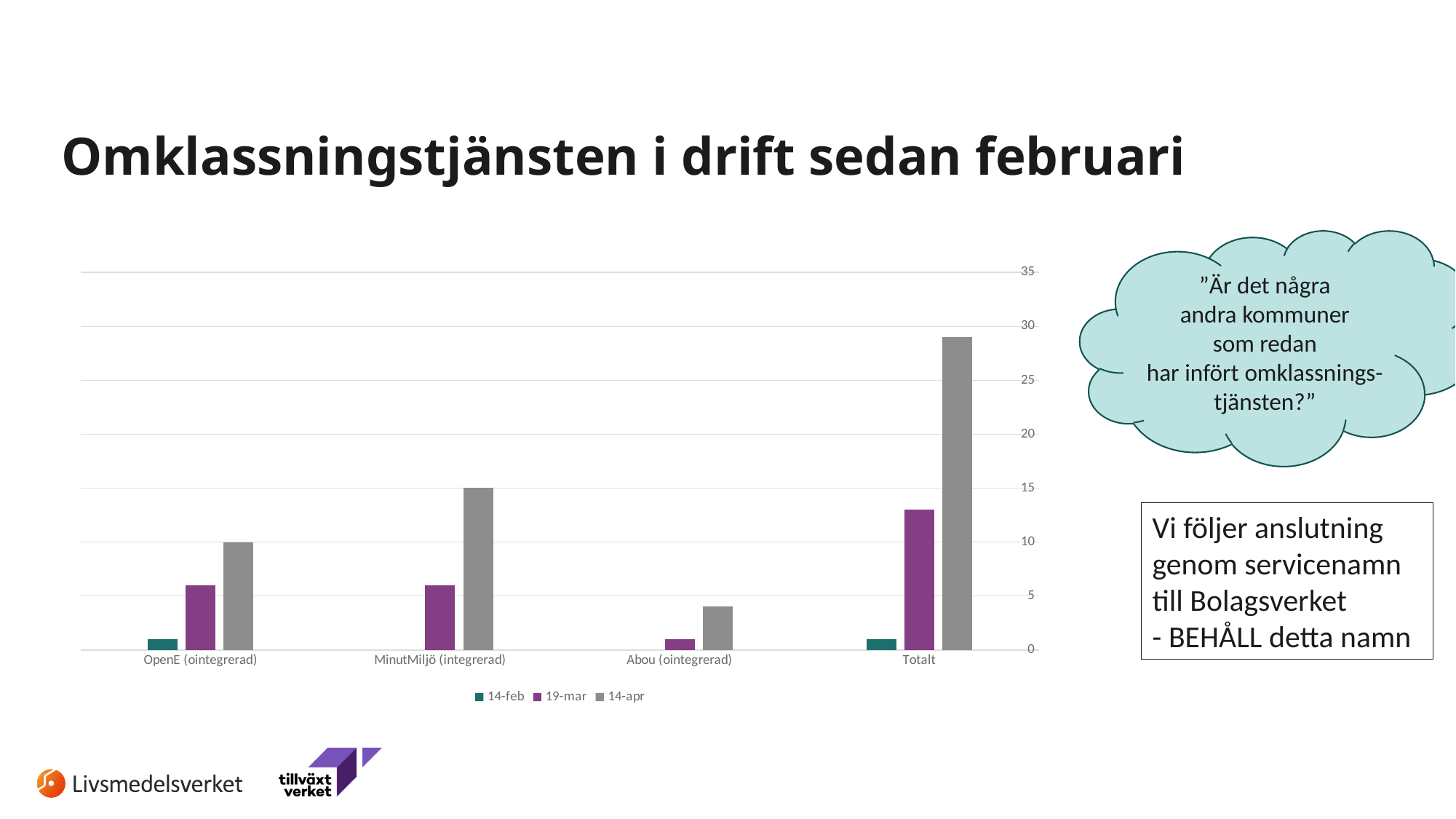
How many categories are shown on the x axis? 4 Which is larger, the 14-apr value for MinutMiljö (integrerad) or the 14-apr value for OpenE (ointegrerad)? MinutMiljö (integrerad) How many series does the legend list? 3 What is the 14-apr value for MinutMiljö (integrerad)? 15 Which series is shown in grey in the legend? 14-apr What is the 14-apr value for OpenE (ointegrerad)? 10 Which category has the highest 14-apr bar? Totalt What kind of chart is shown on the slide? bar chart Is the 14-apr value for Abou (ointegrerad) greater or less than 5? less Which category has the lowest 14-apr bar? Abou (ointegrerad) Is the 19-mar value for Totalt greater or less than 10? greater Is the 14-apr value for Totalt greater or less than 25? greater